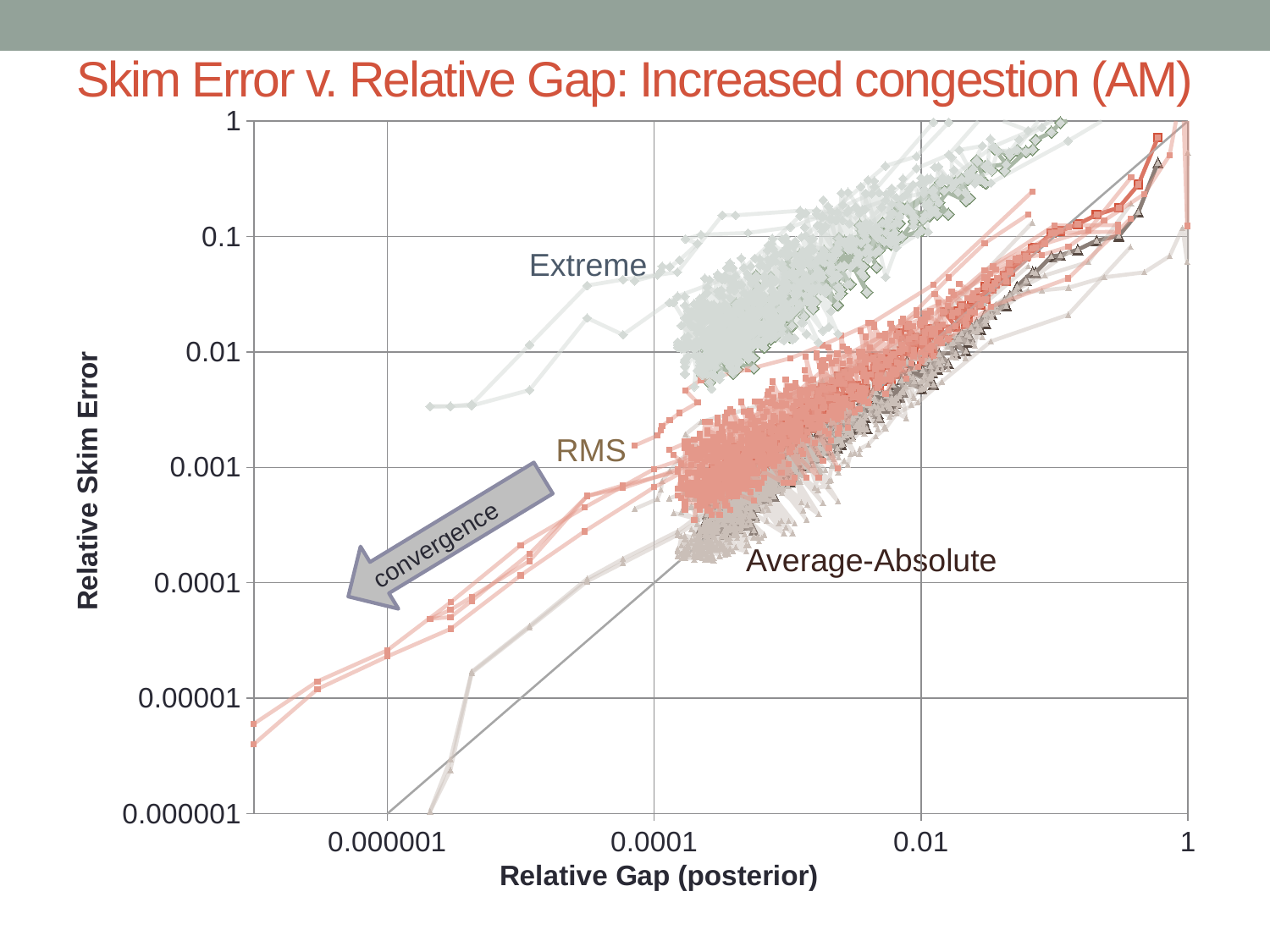
What is the title of the chart? Skim Error v. Relative Gap: Increased congestion (AM) What is the label of the vertical axis? Relative Skim Error At a relative gap of 0.0001, which series has the larger relative skim error, Extreme or RMS? Extreme What is the lowest tick value shown on the vertical axis? 0.000001 Which labeled series has the highest relative skim error at any given relative gap? Extreme Which labeled series has the lowest relative skim error at any given relative gap? Average-Absolute Does the relative skim error rise or fall as the relative gap increases along the x axis? rise How many labeled series (error measures) are plotted on the chart? 3 At a relative gap of 0.0001, is the relative skim error for the Average-Absolute series greater or less than 0.01? less At a relative gap of 0.0001, is the relative skim error for the Extreme series greater or less than 0.001? greater What kind of chart is shown on the slide? Scatter (line) chart with logarithmic axes